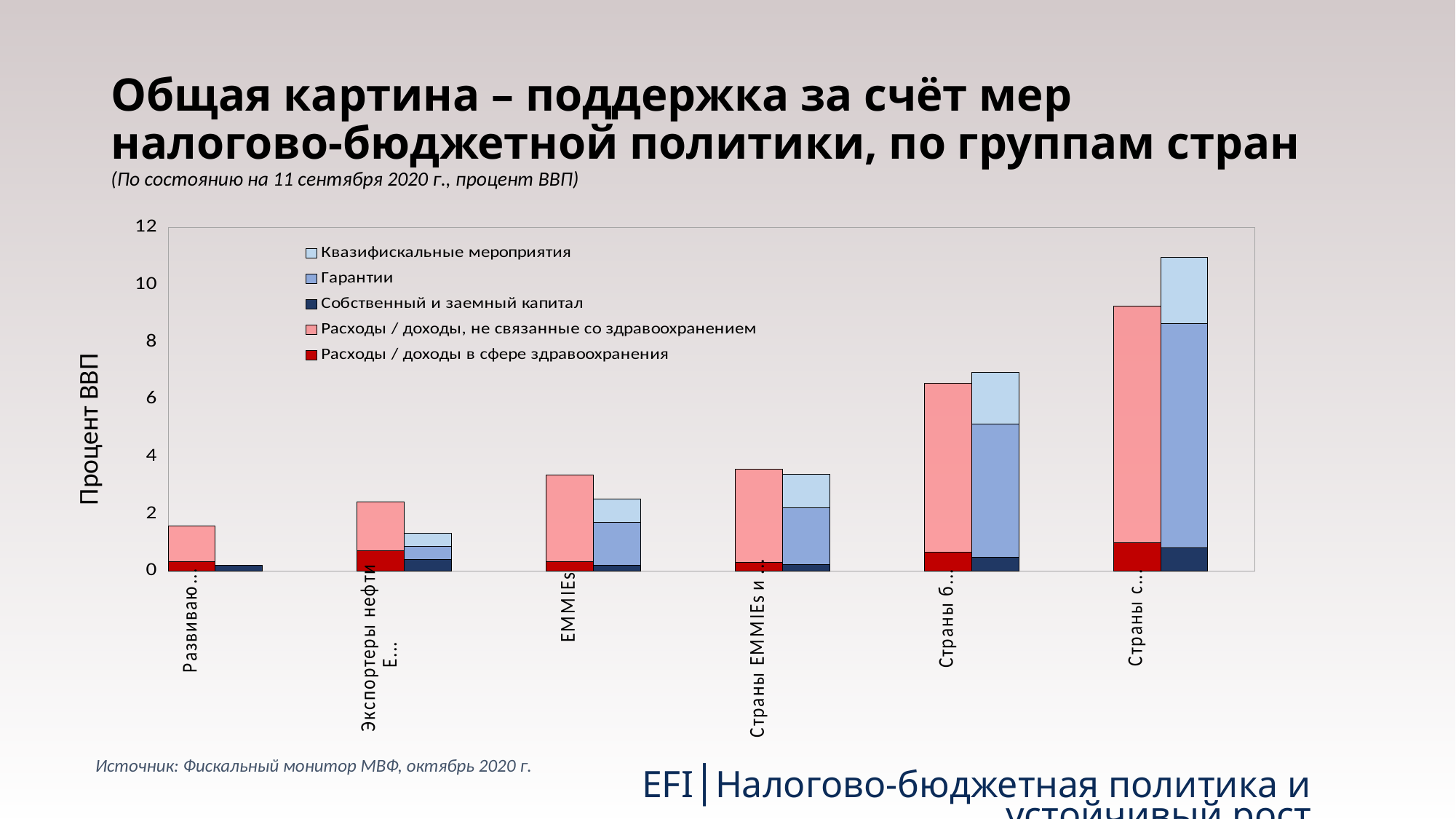
Is the tallest bar on the chart in the leftmost group or the rightmost group? The rightmost group How many country groups are shown along the x axis? 6 Is the total height of the left (red and pink) stacked bar for EMMIEs greater or less than 2? greater For EMMIEs, which stacked bar is taller: the left (red and pink) bar or the right (blue) bar? The left (red and pink) bar What kind of chart is shown on the slide? Stacked bar chart Do the bar heights generally rise or fall from left to right across the country groups? rise Is the total height of the right (blue) stacked bar for EMMIEs greater or less than 4? less What is the label of the y axis? Процент ВВП Is the total height of the tallest bar on the chart greater or less than 10? greater Which series is listed first in the legend? Квазифискальные мероприятия How many series does the legend list? 5